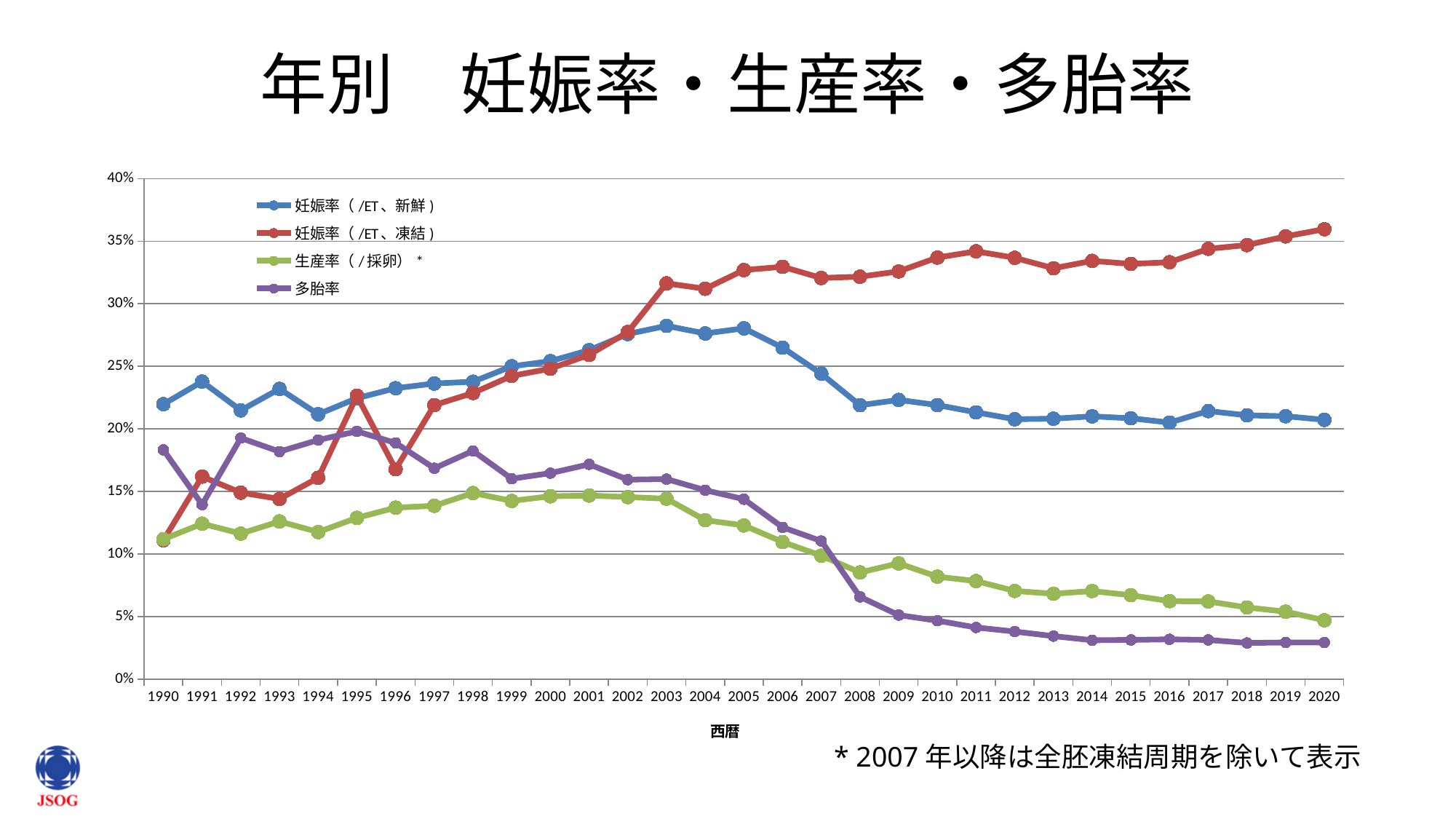
Is the value for 妊娠率（/ET、凍結） in 2020 greater or less than 35%? greater Is the value for 妊娠率（/ET、新鮮） in 2003 greater or less than 25%? greater Is the value for 多胎率 in 2020 greater or less than 5%? less Does 多胎率 rise or fall from 2003 to 2020? fall How many years are plotted along the x axis? 31 What kind of chart is shown on the slide? line chart In 1990, which is higher: 妊娠率（/ET、新鮮） or 多胎率? 妊娠率（/ET、新鮮） How many series does the legend list? 4 Which series has the lowest value in 2020? 多胎率 What is the title of the x axis? 西暦 In 2020, which is higher: 妊娠率（/ET、新鮮） or 妊娠率（/ET、凍結）? 妊娠率（/ET、凍結）